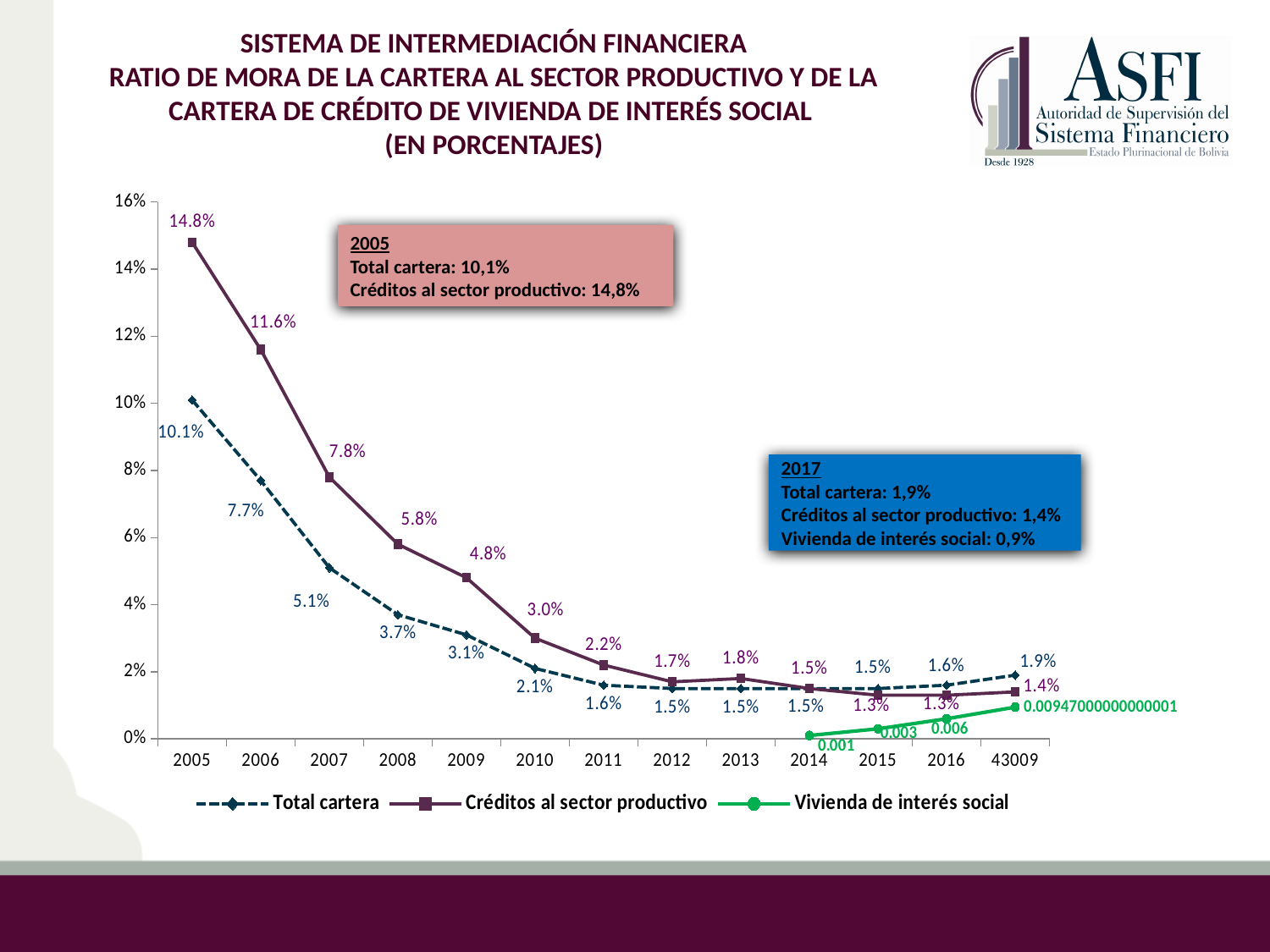
What is the value of Total cartera in 2007? 5.1% What is the value of Créditos al sector productivo in 2010? 3.0% How many points are plotted along the x axis for the Total cartera series? 13 What is the value of Vivienda de interés social in 2016? 0.006 In which year is Créditos al sector productivo at its highest? 2005 Does Total cartera generally rise or fall from 2005 to 2011? Fall What type of chart is shown on the slide? Line chart What is the value of Créditos al sector productivo in 2005? 14.8% In which year is Total cartera at its lowest? 2012, 2013, 2014 and 2015 (tied at 1.5%) Which is larger in 2008, Créditos al sector productivo or Total cartera? Créditos al sector productivo How many series does the legend list? 3 What is the difference between Créditos al sector productivo and Total cartera in 2006? 3.9%